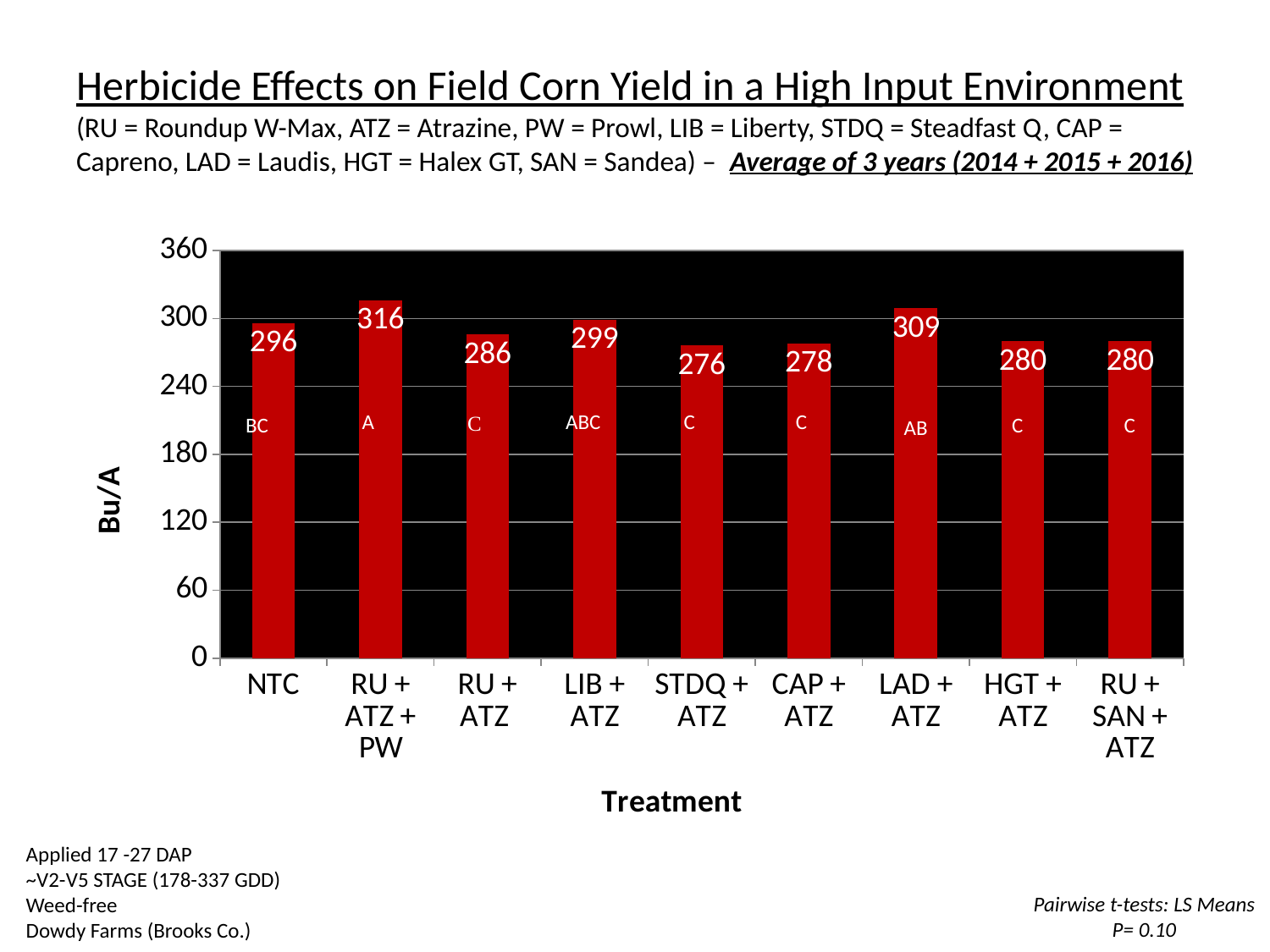
What kind of chart is shown on the slide? bar chart Is the yield for CAP + ATZ greater or less than 300? less What statistical letter grouping is shown on the RU + ATZ + PW bar? A What is the yield (Bu/A) for the RU + ATZ + PW treatment? 316 Which has a higher yield, LIB + ATZ or RU + ATZ? LIB + ATZ Which treatment has the highest yield? RU + ATZ + PW Which treatment has the lowest yield? STDQ + ATZ What is the difference in yield between RU + ATZ + PW and STDQ + ATZ? 40 What is the yield (Bu/A) for the NTC treatment? 296 How many treatments are shown on the x axis? 9 What is the label of the y axis? Bu/A What is the yield (Bu/A) for the LAD + ATZ treatment? 309